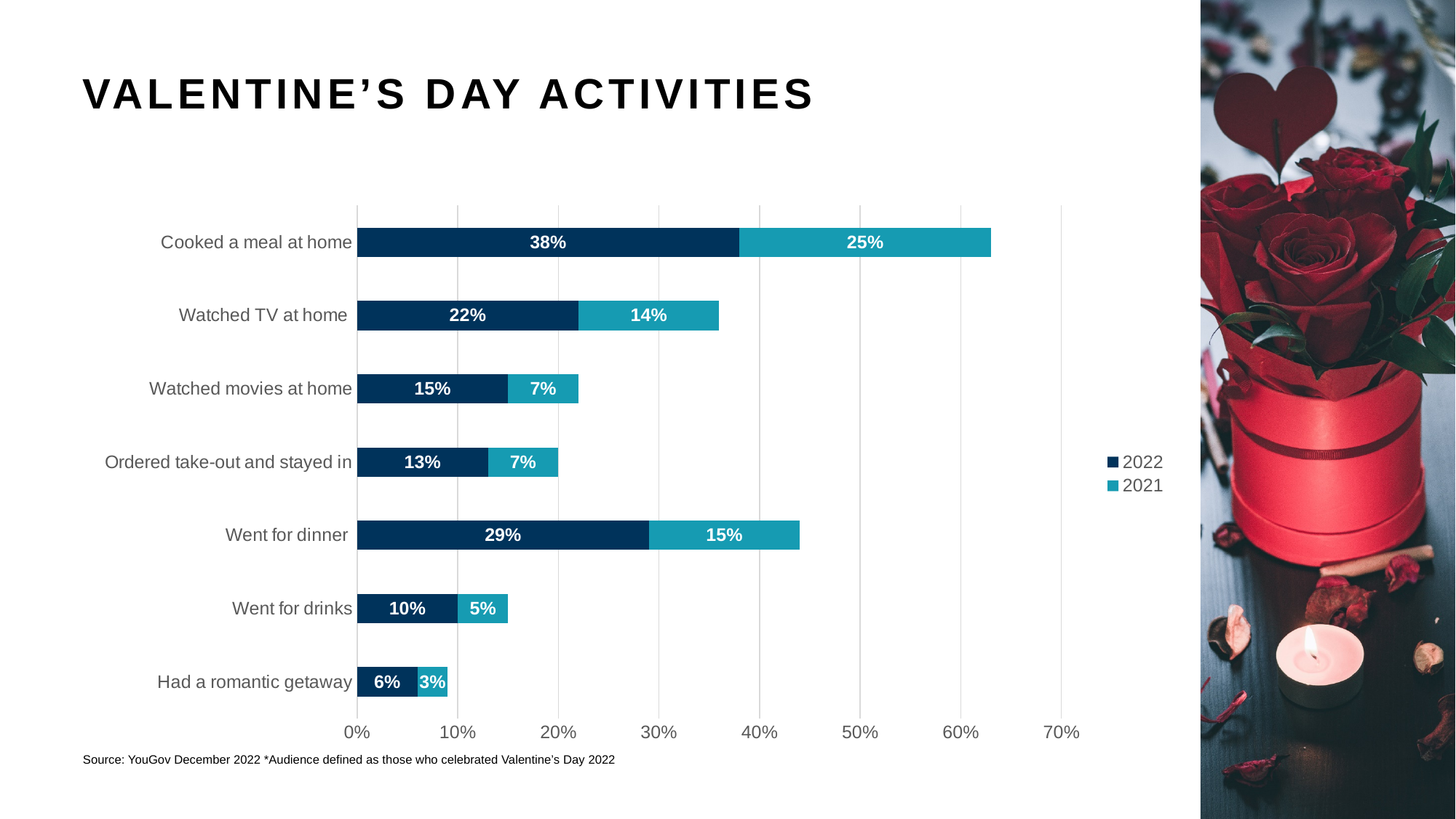
How many activities are shown on the chart? 7 How many series does the legend list? 2 What is the total of the stacked bar for Went for drinks? 15% What is the 2021 value for Watched TV at home? 14% Which activity has the lowest 2021 value? Had a romantic getaway What is the 2022 value for Cooked a meal at home? 38% What is the difference between the 2022 and 2021 values for Went for dinner? 14% What is the 2021 value for Went for dinner? 15% What is the total of the stacked bar for Cooked a meal at home? 63% Which activity has the highest 2022 value? Cooked a meal at home Which is larger: the 2022 value for Watched movies at home or the 2022 value for Ordered take-out and stayed in? Watched movies at home What kind of chart is shown on the slide? Stacked bar chart